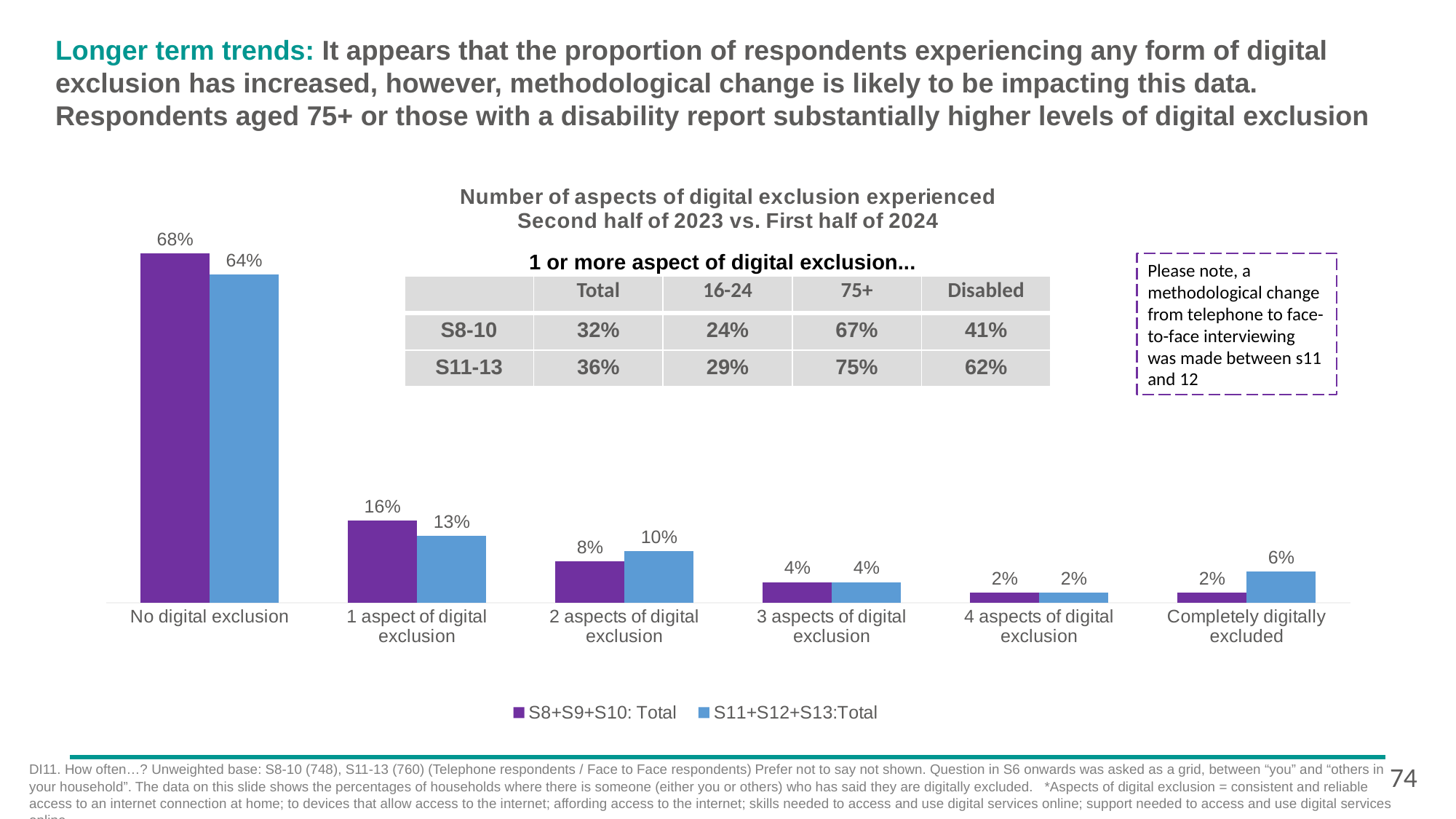
What is the value for 'Completely digitally excluded' in the S11+S12+S13:Total series? 6% Which category has the highest value in the S11+S12+S13:Total series? No digital exclusion What is the title of the chart? Number of aspects of digital exclusion experienced Second half of 2023 vs. First half of 2024 How many categories are shown on the x axis of the chart? 6 What is the difference between the S11+S12+S13:Total and S8+S9+S10: Total values for 'Completely digitally excluded'? 4% What is the value for 'No digital exclusion' in the S8+S9+S10: Total series? 68% For '1 aspect of digital exclusion', which series has the larger value, S8+S9+S10: Total or S11+S12+S13:Total? S8+S9+S10: Total For '2 aspects of digital exclusion', which series has the larger value, S8+S9+S10: Total or S11+S12+S13:Total? S11+S12+S13:Total What is the value for '2 aspects of digital exclusion' in the S11+S12+S13:Total series? 10% How many series does the chart legend list? 2 What is the difference between the S8+S9+S10: Total and S11+S12+S13:Total values for 'No digital exclusion'? 4% What kind of chart is shown on the slide? Bar chart